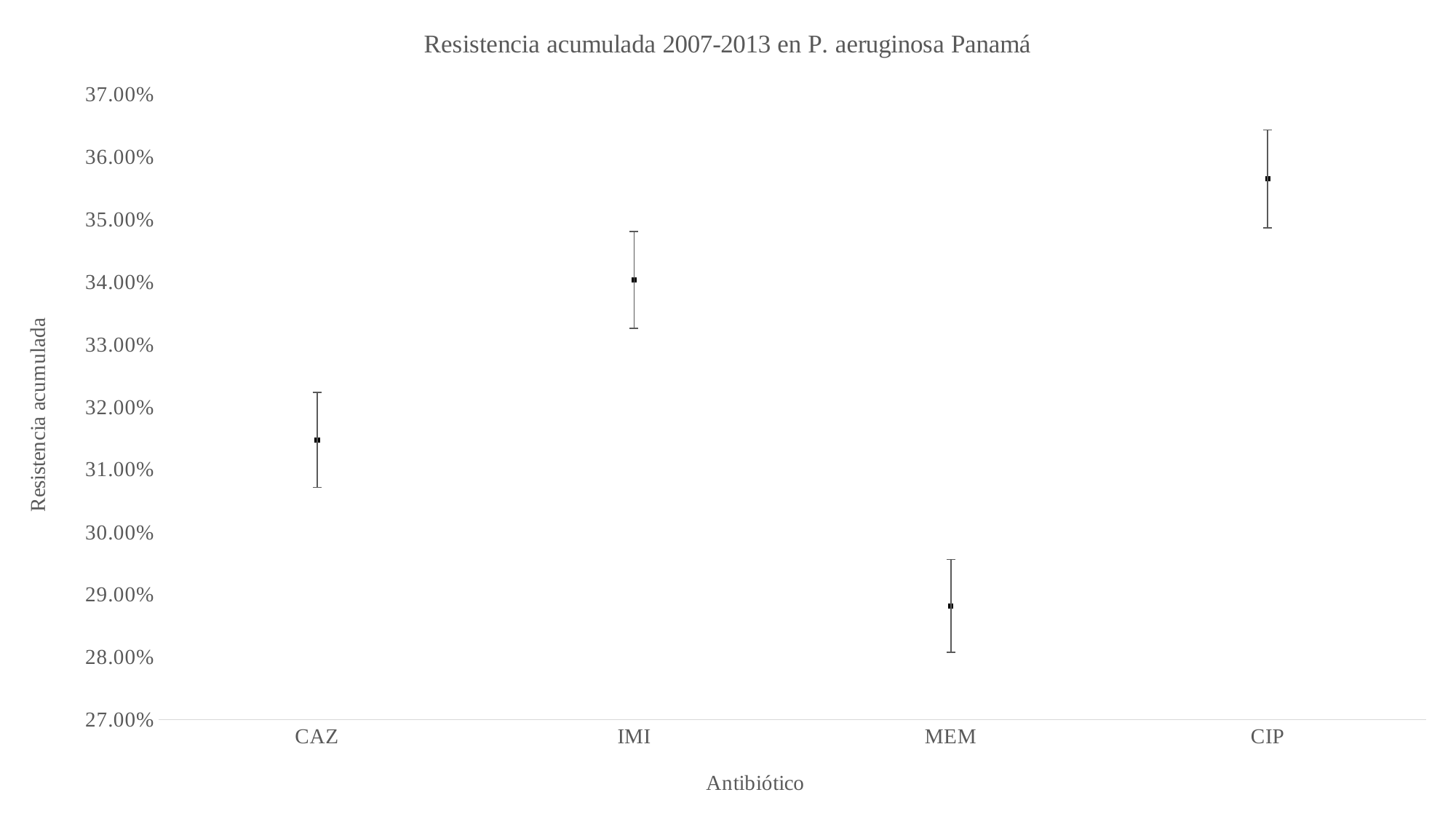
Which has a lower cumulative resistance, MEM or CIP? MEM What kind of chart is shown on the slide? scatter chart with error bars Is the value for IMI greater or less than 33.00%? greater Is the value for CAZ greater or less than 31.00%? greater Is the value for CIP greater or less than 35.00%? greater Which has a higher cumulative resistance, IMI or CAZ? IMI How many antibiotics are plotted on the x axis? 4 What is the label of the x axis? Antibiótico What is the title of the chart? Resistencia acumulada 2007-2013 en P. aeruginosa Panamá Which antibiotic has the lowest cumulative resistance? MEM Which antibiotic has the highest cumulative resistance? CIP